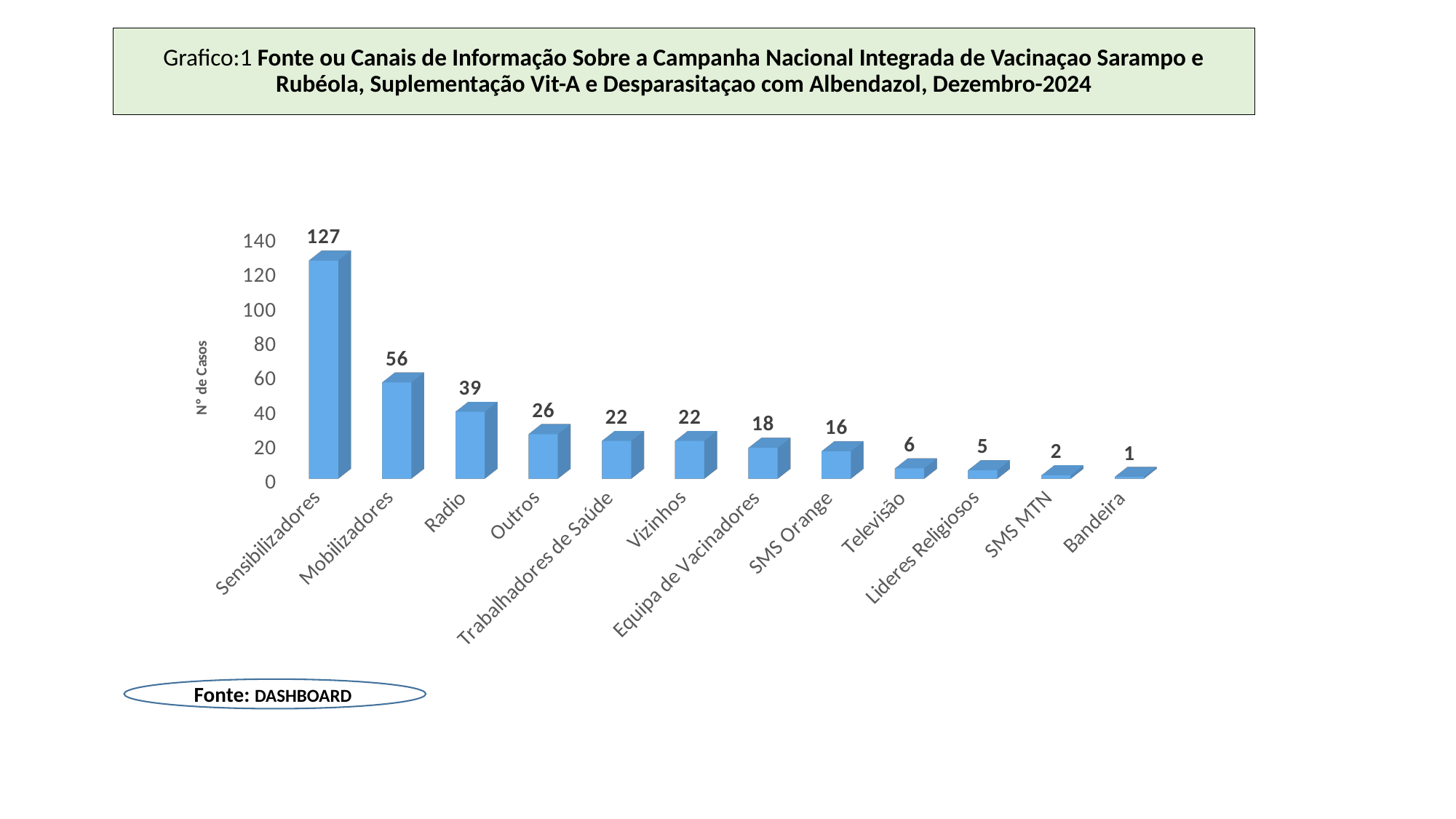
Which is larger, the value for Equipa de Vacinadores or the value for SMS Orange? Equipa de Vacinadores How many categories are shown on the x axis? 12 What is the difference between the values for Sensibilizadores and Mobilizadores? 71 What is the value for Radio? 39 Which category has the highest value? Sensibilizadores What is the label of the vertical axis? N° de Casos What kind of chart is shown on the slide? bar chart What is the value for SMS Orange? 16 Which category has the lowest value? Bandeira What is the value for Sensibilizadores? 127 What is the difference between the values for Outros and Televisão? 20 Is the value for Mobilizadores greater or less than 40? greater